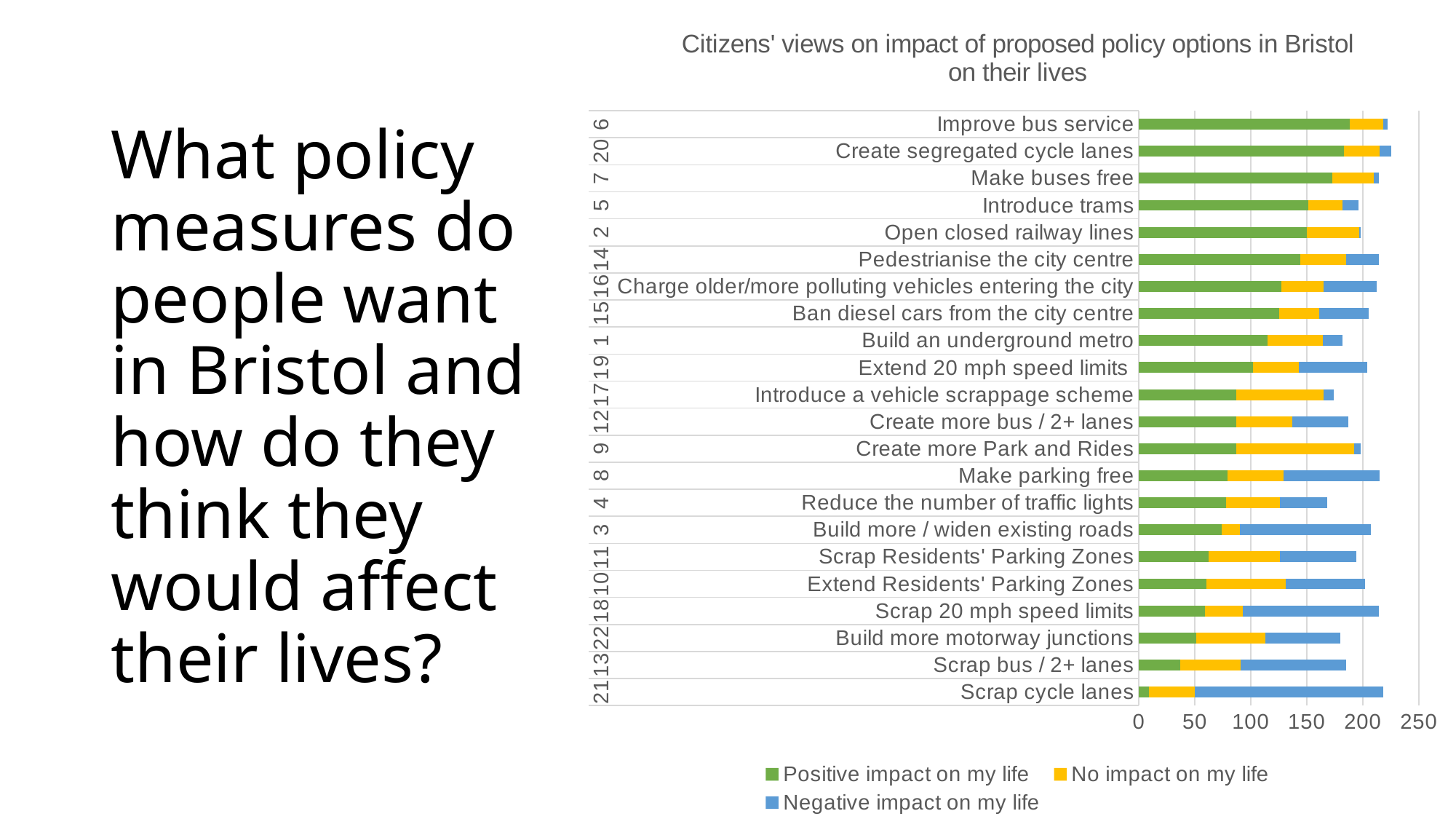
How many policy options are plotted in the chart? 22 Is the 'Positive impact on my life' value for Build an underground metro greater or less than 100? greater Which policy option has the lowest 'Positive impact on my life' value? Scrap cycle lanes How many series does the chart's legend list? 3 Is the 'Positive impact on my life' value for Scrap cycle lanes greater or less than 50? less What is the title of the chart? Citizens' views on impact of proposed policy options in Bristol on their lives What kind of chart is shown on the slide? Stacked horizontal bar chart Is the 'Positive impact on my life' value for Improve bus service greater or less than 150? greater Which series is shown in blue in the chart? Negative impact on my life Which policy option has the highest 'Negative impact on my life' value? Scrap cycle lanes Going down the chart from Improve bus service to Scrap cycle lanes, do the 'Positive impact on my life' values generally rise or fall? fall Which has the larger 'Positive impact on my life' value: Make parking free or Scrap 20 mph speed limits? Make parking free